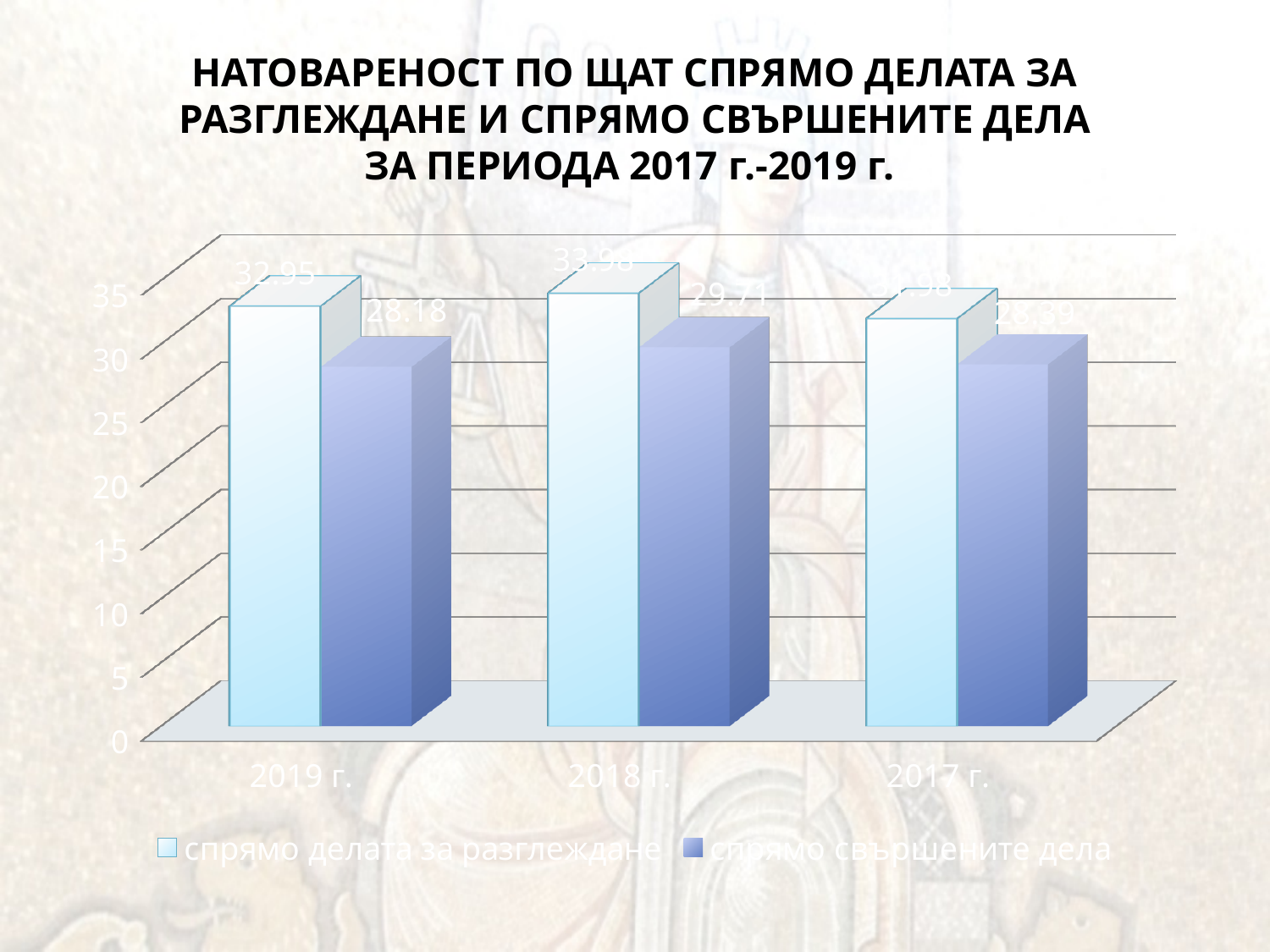
Which year has the highest value in the series "спрямо свършените дела"? 2018 г. Is the value for 2017 г. in the series "спрямо делата за разглеждане" greater or less than 30? greater For 2019 г., which series has the larger value: "спрямо делата за разглеждане" or "спрямо свършените дела"? спрямо делата за разглеждане What is the value for 2018 г. in the series "спрямо делата за разглеждане"? 33.98 What is the value for 2018 г. in the series "спрямо свършените дела"? 29.71 How many series does the legend list? 2 What is the difference between the two series for 2018 г.? 4.27 What is the value for 2017 г. in the series "спрямо свършените дела"? 28.39 What is the value for 2019 г. in the series "спрямо делата за разглеждане"? 32.95 Which year has the lowest value in the series "спрямо свършените дела"? 2019 г. What is the value for 2019 г. in the series "спрямо свършените дела"? 28.18 What kind of chart is shown on the slide? bar chart